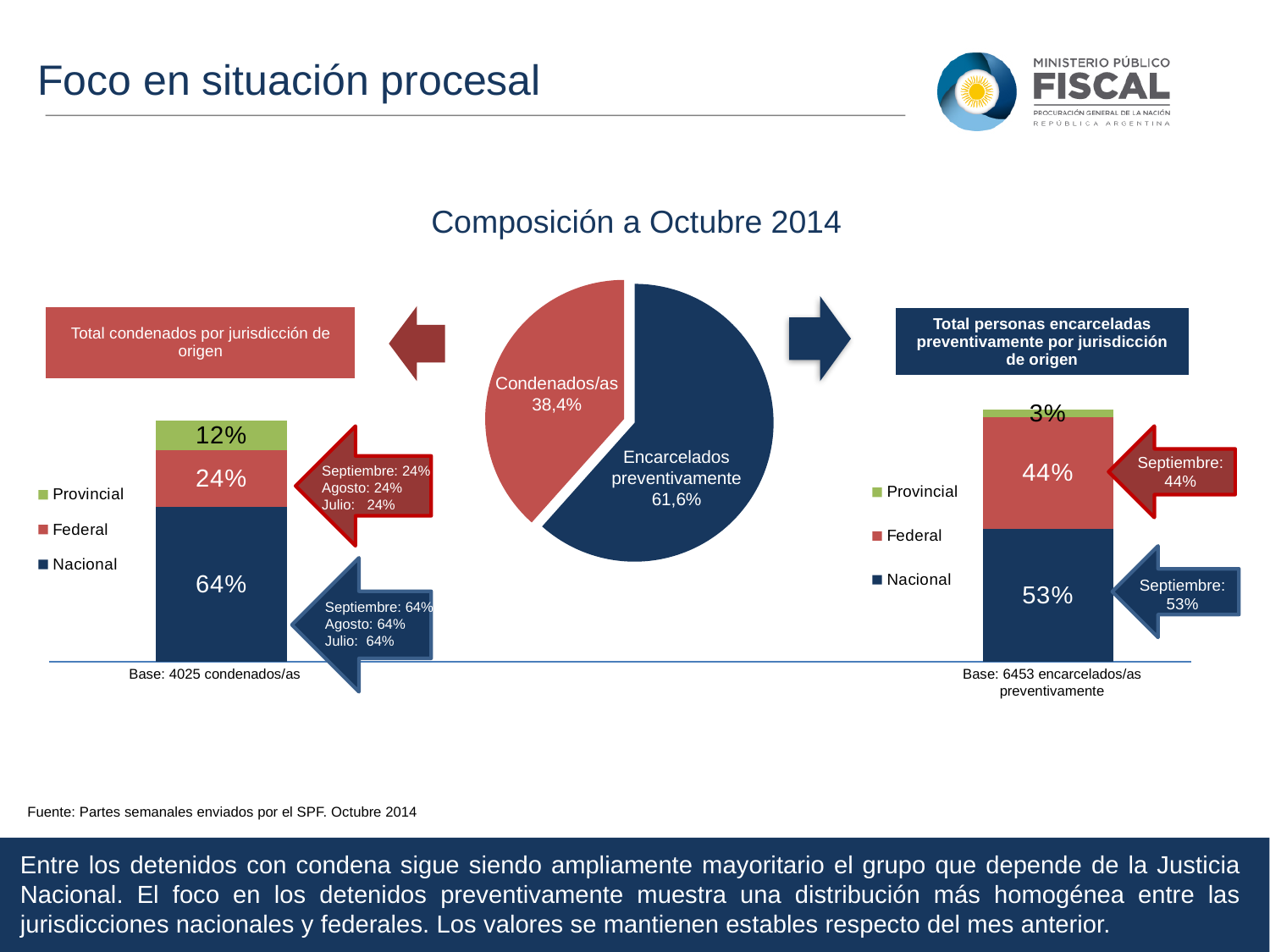
In the right stacked bar chart (Total personas encarceladas preventivamente por jurisdicción de origen), what is the value for Nacional? 53% In the left stacked bar chart (Total condenados por jurisdicción de origen), what is the difference between the Nacional and Federal values? 40% In the right stacked bar chart (Total personas encarceladas preventivamente por jurisdicción de origen), what is the value for Federal? 44% In the pie chart in the centre of the slide, what share is labelled for Encarcelados preventivamente? 61,6% How many series does the legend of the left stacked bar chart (Total condenados por jurisdicción de origen) list? 3 In the pie chart in the centre of the slide, which slice is larger, Condenados/as or Encarcelados preventivamente? Encarcelados preventivamente In the right stacked bar chart (Total personas encarceladas preventivamente por jurisdicción de origen), what is the difference between the Nacional and Federal values? 9% In the left stacked bar chart (Total condenados por jurisdicción de origen), which jurisdiction has the smallest share? Provincial In the right stacked bar chart (Total personas encarceladas preventivamente por jurisdicción de origen), which jurisdiction has the largest share? Nacional In the left stacked bar chart (Total condenados por jurisdicción de origen), what is the value for Provincial? 12% In the left stacked bar chart (Total condenados por jurisdicción de origen), what is the value for Nacional? 64% In the pie chart in the centre of the slide, what share is labelled for Condenados/as? 38,4%